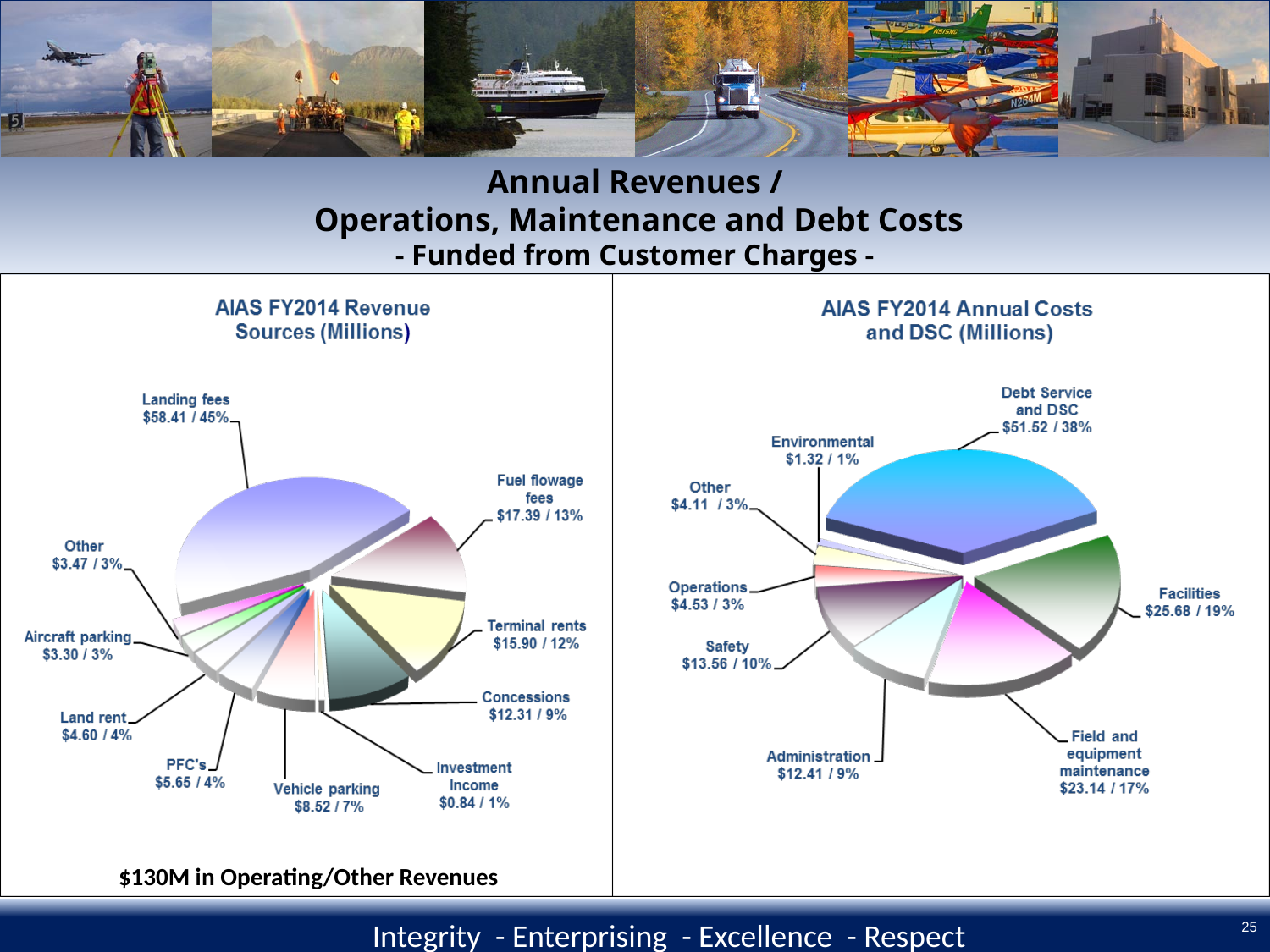
In the 'AIAS FY2014 Annual Costs and DSC (Millions)' chart, which category is the largest? Debt Service and DSC In the 'AIAS FY2014 Revenue Sources (Millions)' chart, what is the value for Landing fees? $58.41 In the 'AIAS FY2014 Revenue Sources (Millions)' chart, which is larger, Vehicle parking or PFC's? Vehicle parking What type of chart is the 'AIAS FY2014 Revenue Sources (Millions)' chart? Pie chart In the 'AIAS FY2014 Revenue Sources (Millions)' chart, which category is the smallest? Investment Income In the 'AIAS FY2014 Revenue Sources (Millions)' chart, what share of the pie is Fuel flowage fees? 13% In the 'AIAS FY2014 Annual Costs and DSC (Millions)' chart, what share of the pie is Safety? 10% How many categories are shown in the 'AIAS FY2014 Annual Costs and DSC (Millions)' chart? 8 In the 'AIAS FY2014 Revenue Sources (Millions)' chart, what is the difference between Terminal rents and Concessions? $3.59 In the 'AIAS FY2014 Annual Costs and DSC (Millions)' chart, what is the value for Facilities? $25.68 In the 'AIAS FY2014 Annual Costs and DSC (Millions)' chart, what is the difference between Facilities and Field and equipment maintenance? $2.54 How many categories are shown in the 'AIAS FY2014 Revenue Sources (Millions)' chart? 10